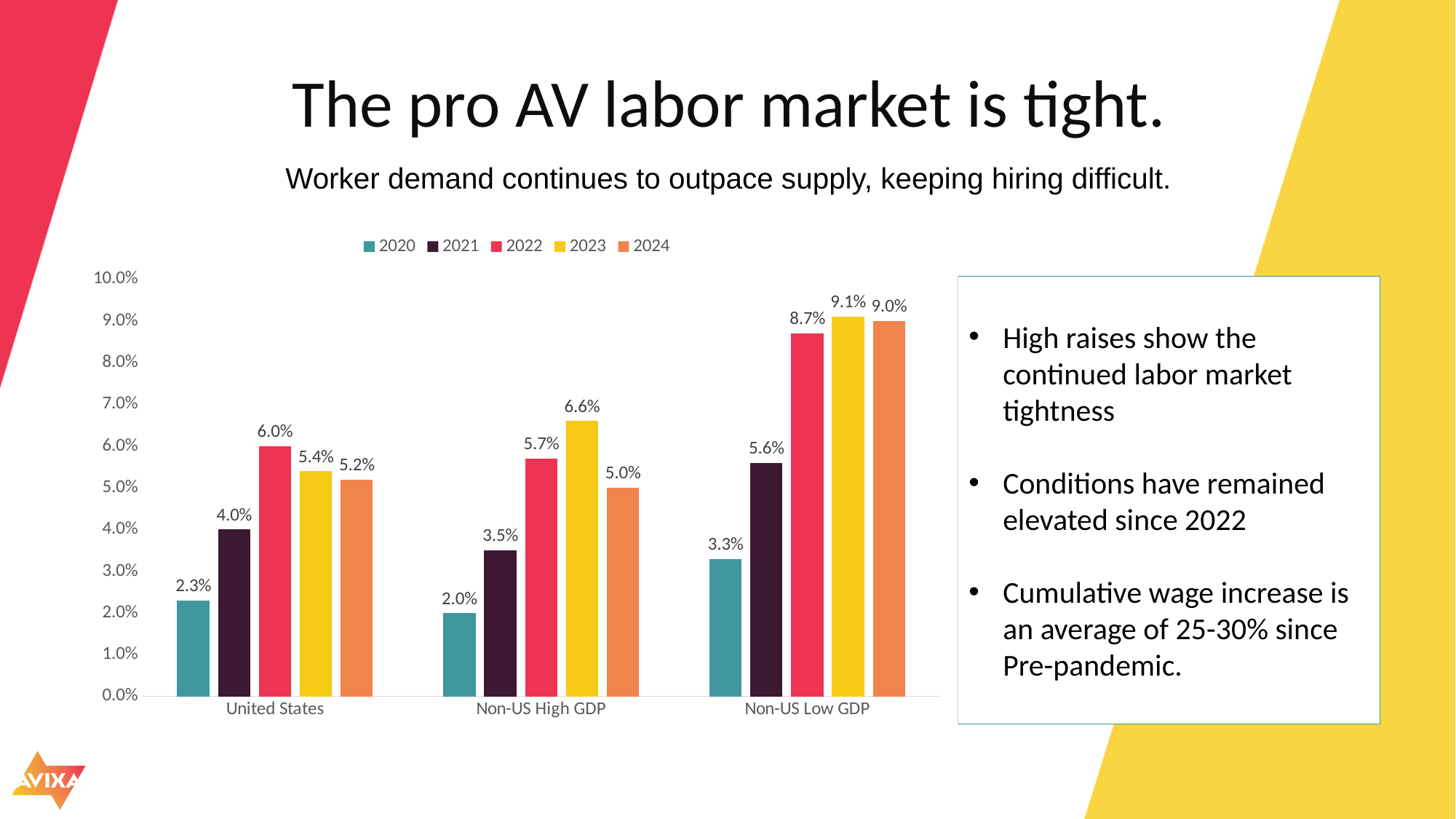
Which colour represents the 2023 series in the legend? yellow What kind of chart is shown on the slide? bar chart How many series does the legend list? 5 What is the difference between the 2021 and 2020 values for Non-US Low GDP? 2.3% How many categories are shown on the x axis? 3 Which year has the highest value in the Non-US High GDP category? 2023 What is the value for 2023 in the Non-US Low GDP category? 9.1% Which year has the lowest value in the United States category? 2020 Is the 2022 value for Non-US Low GDP greater or less than 8.0%? greater What is the value for 2022 in the United States category? 6.0% Which is larger: the 2024 value for United States or the 2024 value for Non-US High GDP? United States What is the value for 2020 in the Non-US High GDP category? 2.0%